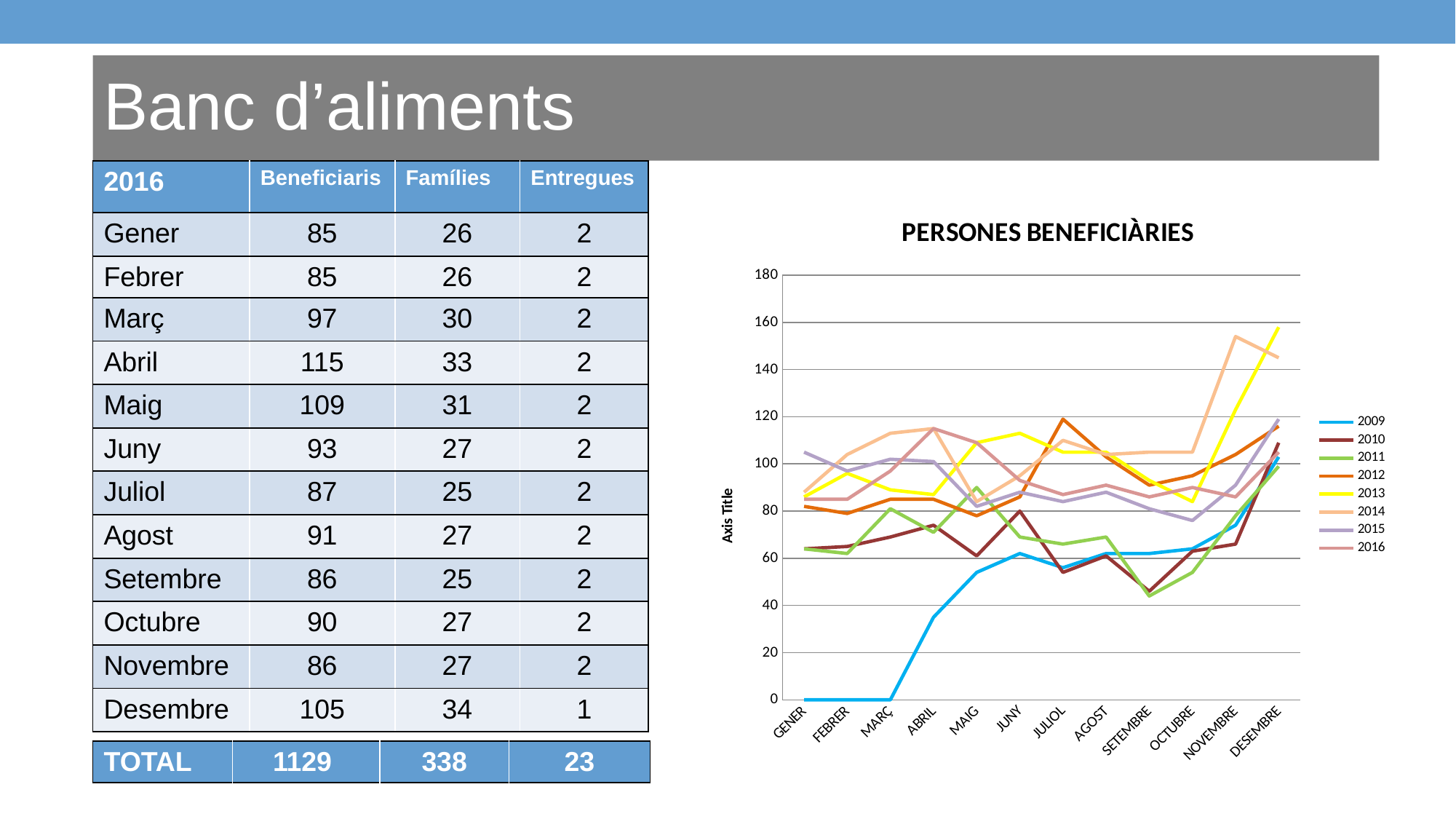
Which series has the highest value at DESEMBRE in the chart? 2013 What is the value of the 2009 series for GENER in the chart? 0 How many series does the chart legend list? 8 Is the value of the 2009 series for ABRIL greater or less than 40? less Does the 2009 series rise or fall overall from GENER to DESEMBRE? rise Is the value of the 2013 series for DESEMBRE greater or less than 140? greater What type of chart is shown on the slide? line chart At NOVEMBRE, which series has the larger value, 2014 or 2013? 2014 How many months are shown along the x axis of the chart? 12 What is the title of the chart? PERSONES BENEFICIÀRIES Which series has the lowest value at GENER in the chart? 2009 Is the value of the 2011 series for SETEMBRE greater or less than 60? less